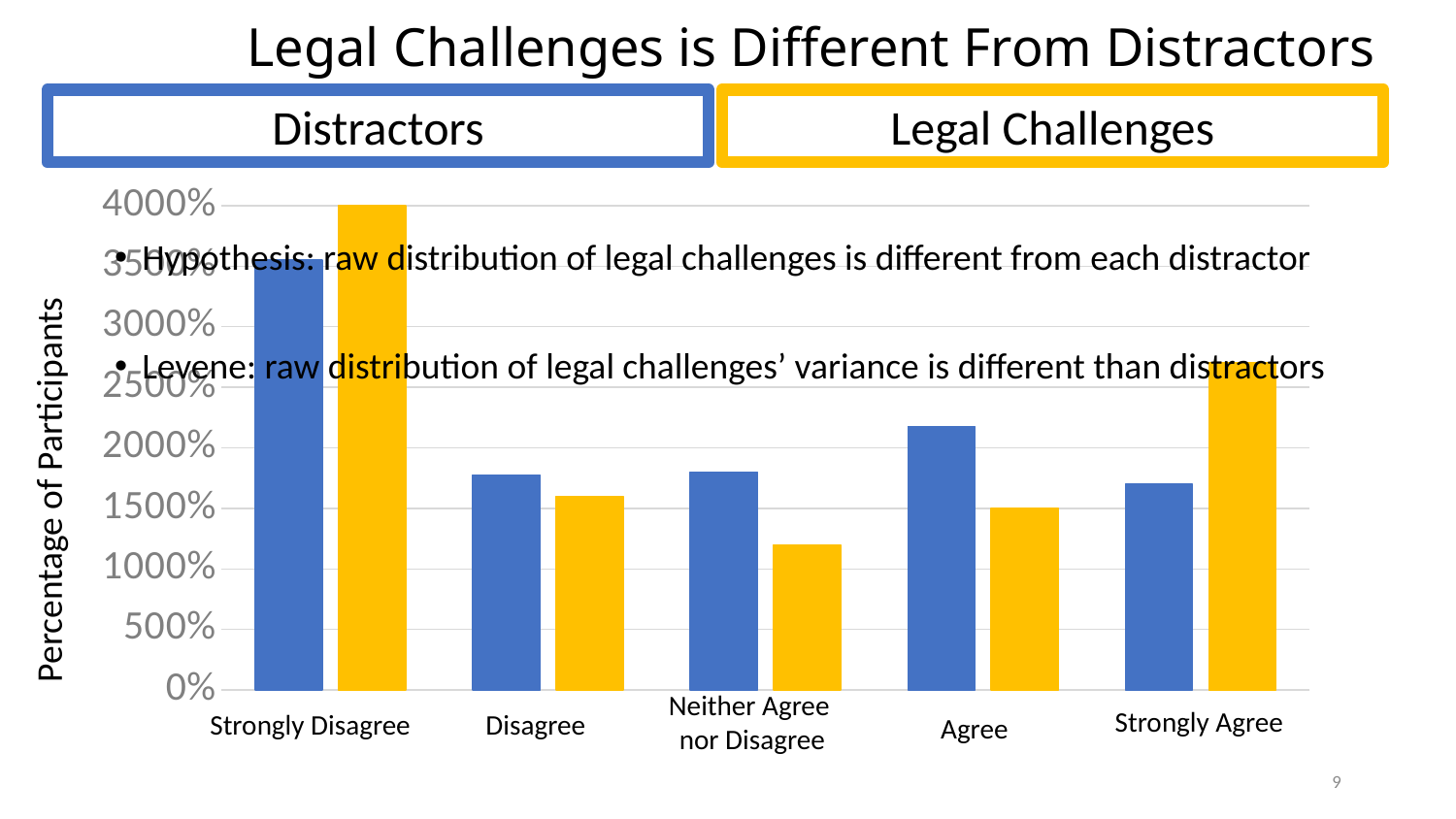
How many response categories are shown on the x axis? 5 For the Agree category, which series has the larger value, Distractors or Legal Challenges? Distractors What kind of chart is shown on the slide? bar chart For the Legal Challenges series, which category has the lowest value? Neither Agree nor Disagree For the Legal Challenges series, which category has the highest value? Strongly Disagree For the Distractors series, which category has the highest value? Strongly Disagree Which colour represents the Legal Challenges series? yellow Is the Legal Challenges value for Neither Agree nor Disagree greater or less than 1500%? less What is the title of the y axis? Percentage of Participants How many series does the chart show? 2 Is the Distractors value for Agree greater or less than 2000%? greater For the Strongly Agree category, which series has the larger value, Distractors or Legal Challenges? Legal Challenges